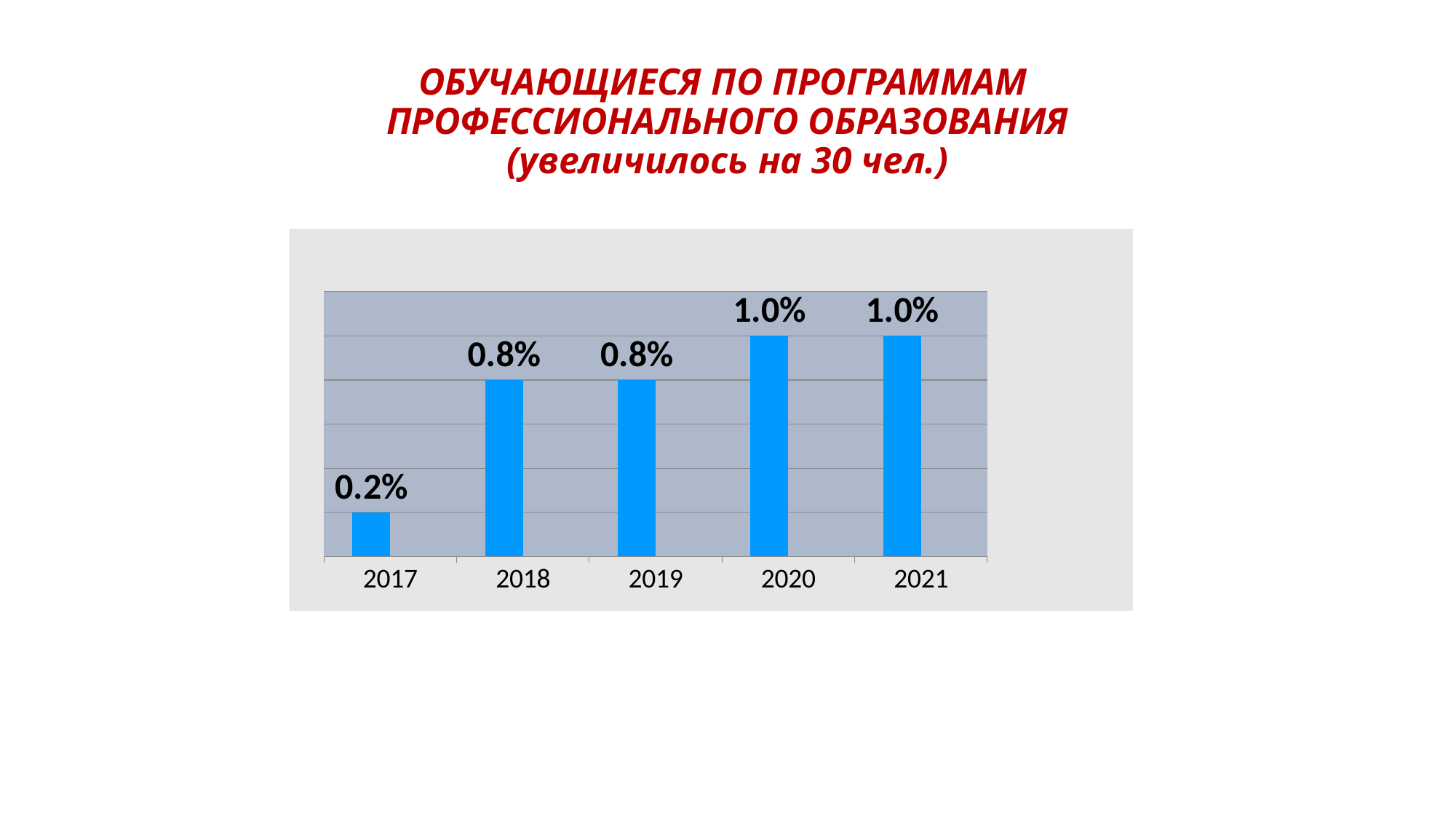
Which is larger, the value for 2019 or the value for 2021? 2021 What is the difference between the values for 2020 and 2019? 0.2% What is the value for 2018? 0.8% What is the value for 2020? 1.0% What colour are the bars in the chart? blue Do the values rise or fall from 2017 to 2021? rise What is the difference between the values for 2018 and 2017? 0.6% How many years are shown on the x axis? 5 What is the value for 2017? 0.2% Which two years share the value 0.8%? 2018 and 2019 Which year has the lowest value? 2017 What kind of chart is shown on the slide? bar chart